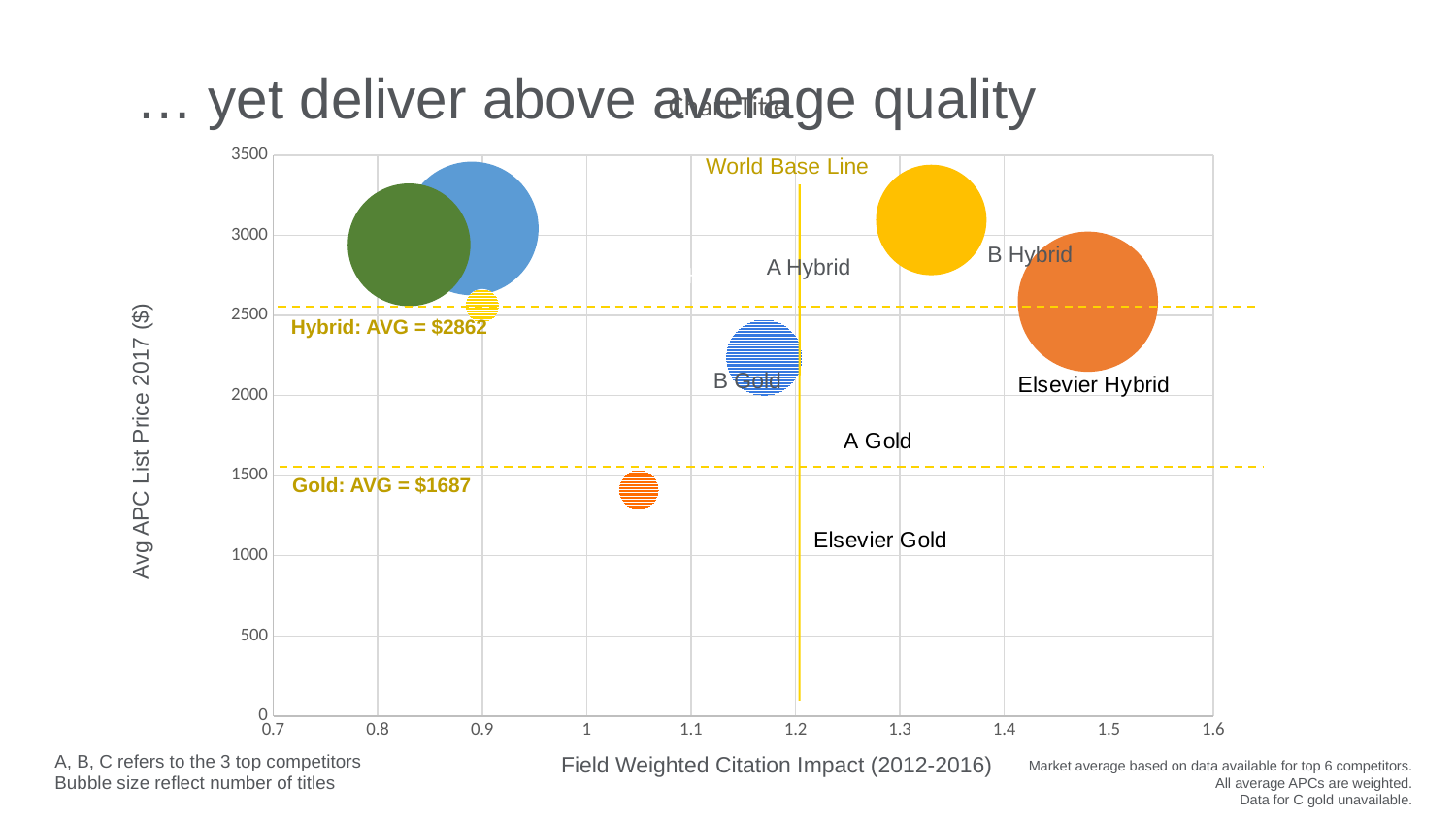
How many bubbles are plotted on the chart? 7 What is the Gold average APC shown on the chart? $1687 What is the Hybrid average APC shown on the chart? $2862 Is the Field Weighted Citation Impact for the Elsevier Hybrid bubble greater or less than 1.4? greater At what Field Weighted Citation Impact value is the World Base Line drawn? 1.2 What is the label of the x axis? Field Weighted Citation Impact (2012-2016) What does the bubble size represent, according to the slide? Number of titles Which average is higher on the chart, Hybrid or Gold? Hybrid What is the difference between the Hybrid average ($2862) and the Gold average ($1687) shown on the chart? $1175 What kind of chart is shown on the slide? Bubble chart What is the label of the y axis? Avg APC List Price 2017 ($)